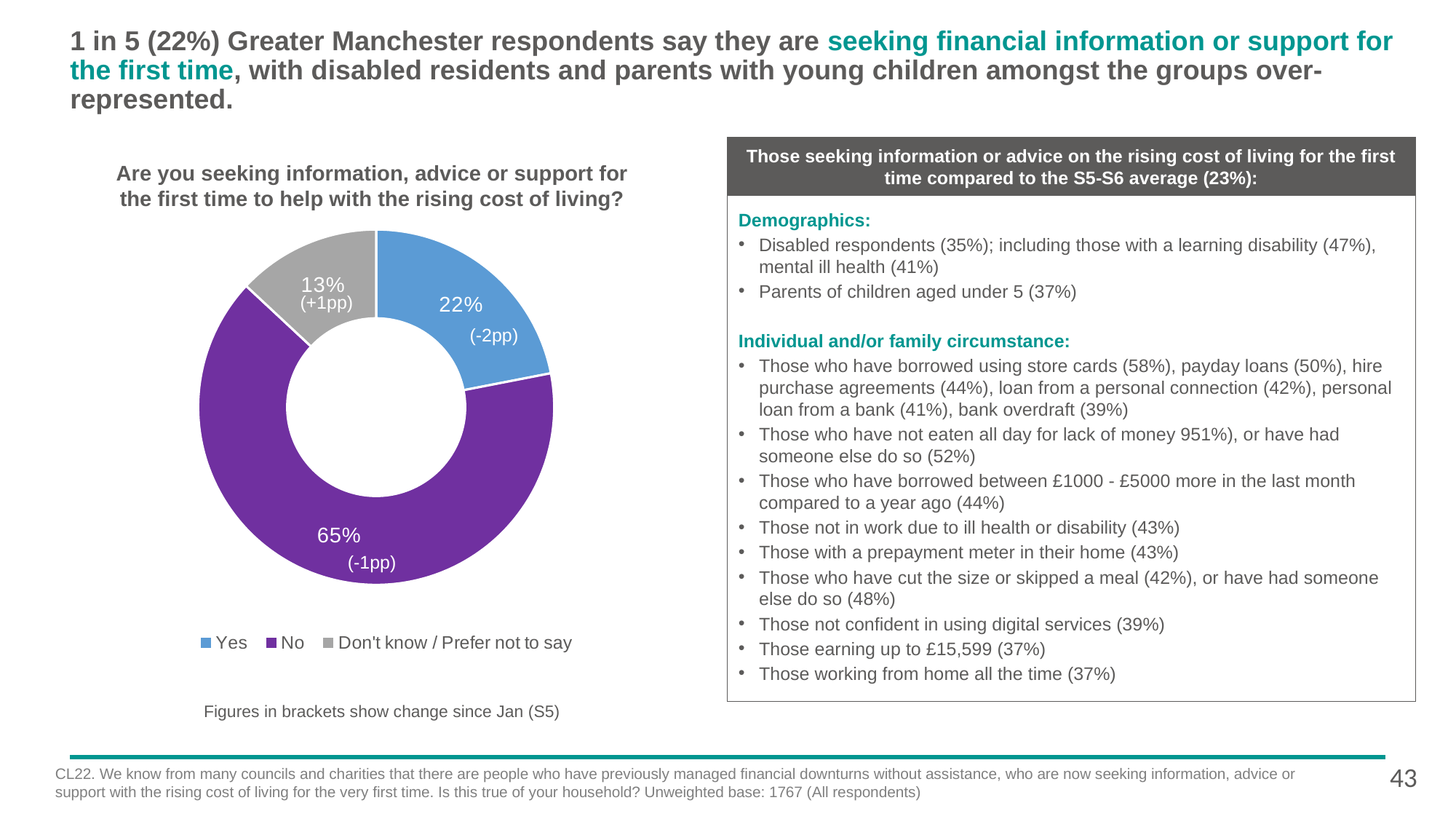
Which response has the largest share of the chart? No How many categories does the chart show? 3 What kind of chart is shown on the slide? Doughnut (pie) chart What is the difference in percentage points between the 'No' and 'Yes' shares? 43 What percentage of respondents answered 'Yes' to seeking information, advice or support for the first time? 22% What percentage of respondents answered 'No'? 65% Which is larger, the 'Yes' share or the 'Don't know / Prefer not to say' share? Yes Which response has the smallest share of the chart? Don't know / Prefer not to say What is the change since Jan (S5) shown in brackets for the 'Yes' share? -2pp What is the change since Jan (S5) shown in brackets for the 'Don't know / Prefer not to say' share? +1pp What percentage of respondents answered 'Don't know / Prefer not to say'? 13% What colour represents the 'No' response in the chart? Purple